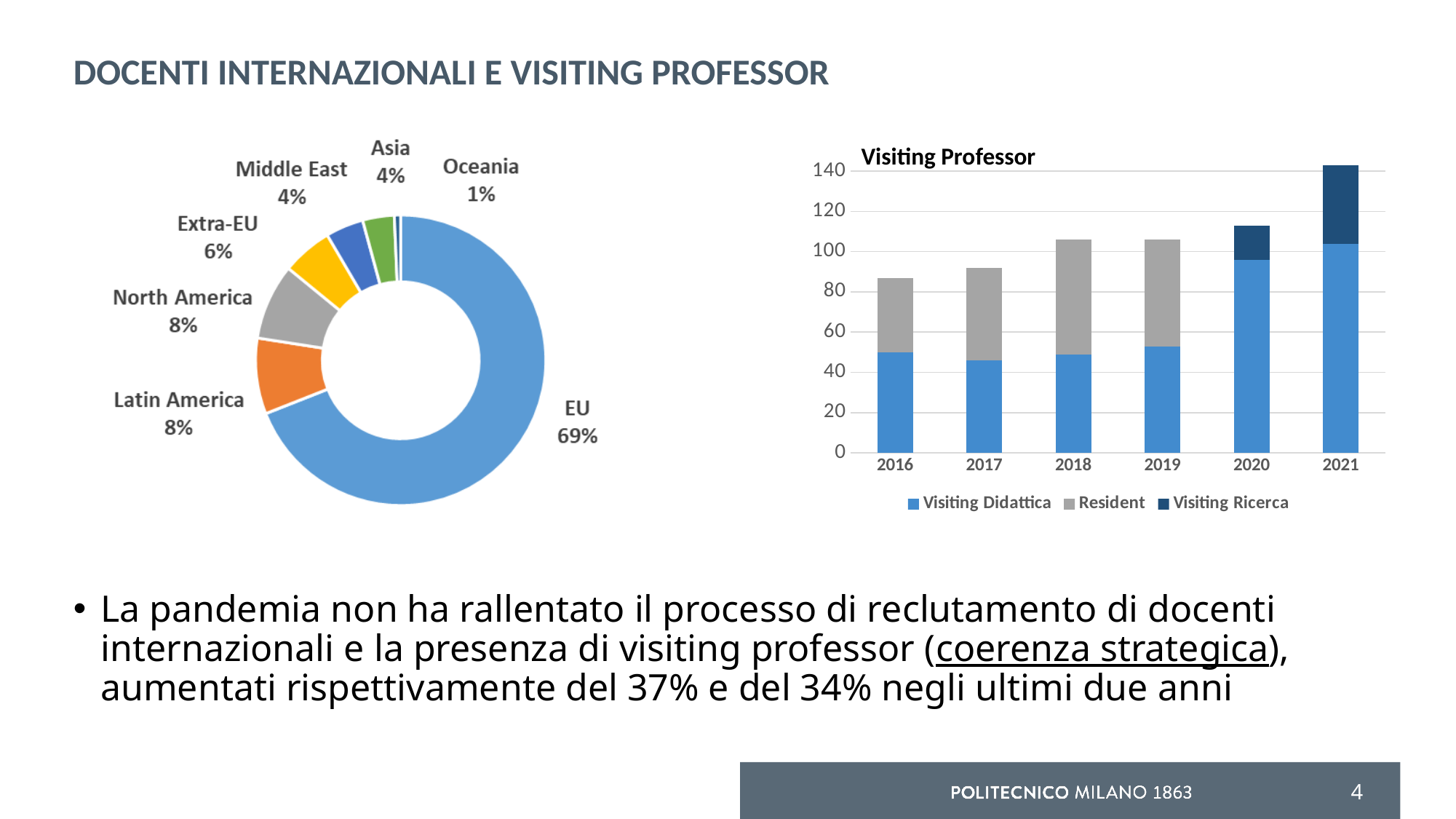
In the 'Visiting Professor' chart, which year has the highest total bar? 2021 In the 'Visiting Professor' chart, how many series does the legend list? 3 In the 'Visiting Professor' chart, is the total for 2020 greater or less than 100? greater What kind of chart is the 'Visiting Professor' chart? Stacked bar chart In the donut chart on the left, what share does EU have? 69% In the 'Visiting Professor' chart, is the total for 2016 greater or less than 100? less In the donut chart on the left, what is the difference between the EU share and the Latin America share? 61% In the 'Visiting Professor' chart, which year has the lowest total bar? 2016 In the donut chart on the left, what share does Extra-EU have? 6% In the donut chart on the left, which region has the largest share? EU In the donut chart on the left, which region has the smallest share? Oceania How many regions are shown in the donut chart on the left? 7